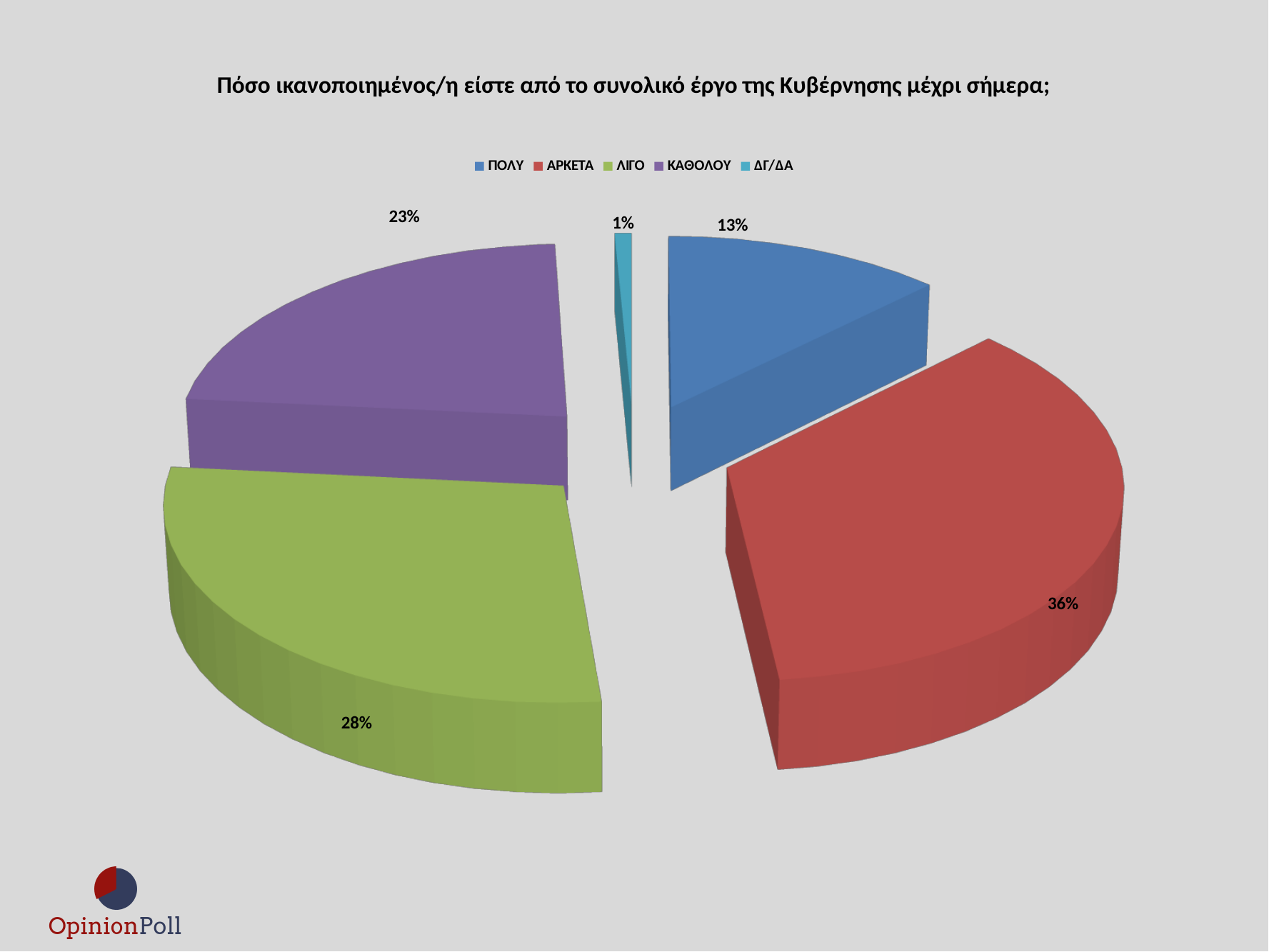
Which is larger, the value for ΚΑΘΟΛΟΥ or the value for ΠΟΛΥ? ΚΑΘΟΛΟΥ What is the value for ΠΟΛΥ? 13% Which category has the largest share? ΑΡΚΕΤΑ What is the value for ΛΙΓΟ? 28% Which category has the smallest share? ΔΓ/ΔΑ How many categories does the legend list? 5 What is the value for ΚΑΘΟΛΟΥ? 23% What is the difference between the values for ΑΡΚΕΤΑ and ΛΙΓΟ? 8% What colour is the slice for ΛΙΓΟ? green What kind of chart is shown on the slide? pie chart What is the value for ΔΓ/ΔΑ? 1% What is the value for ΑΡΚΕΤΑ? 36%